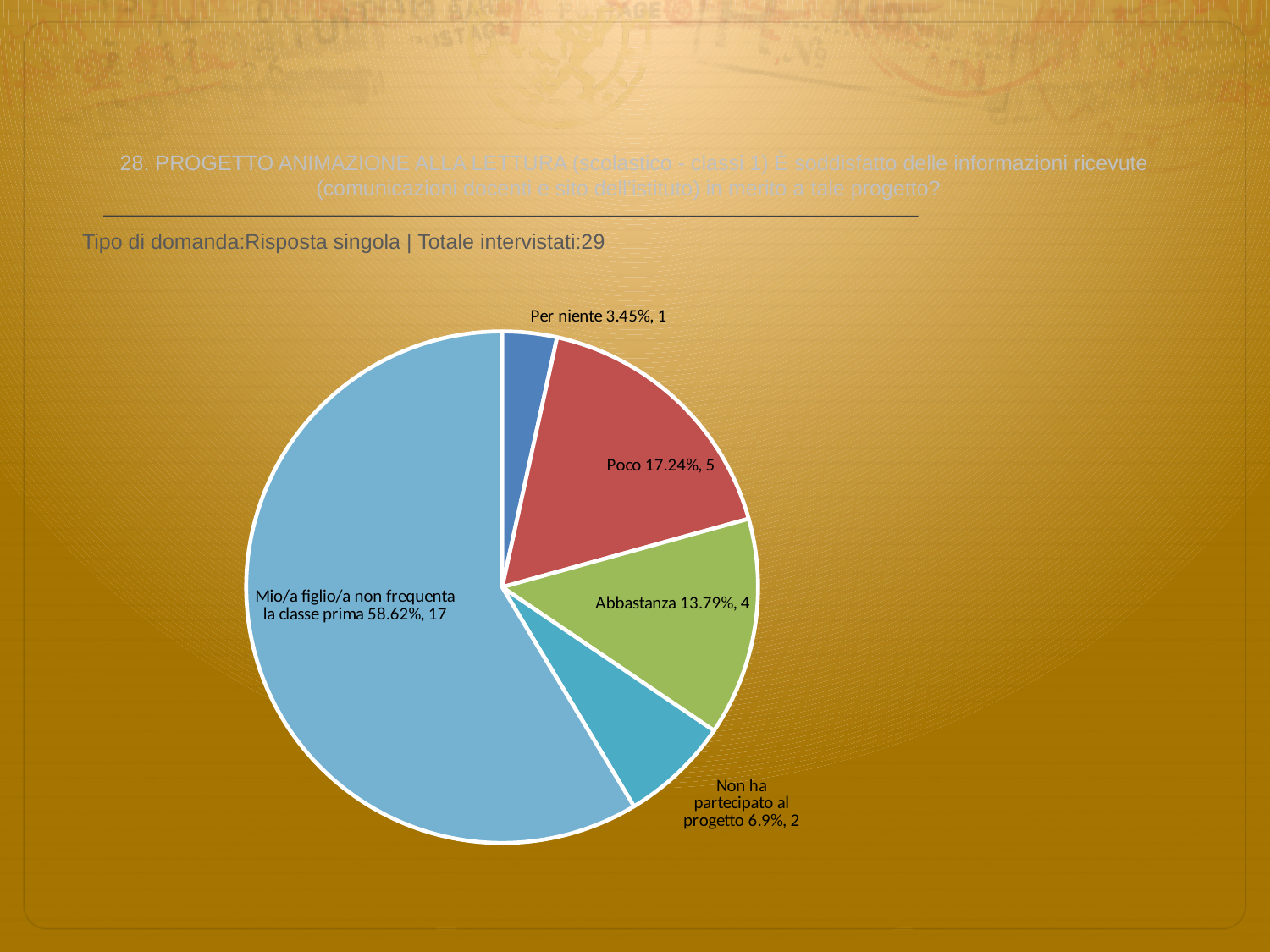
How many respondents answered 'Abbastanza'? 4 Which category has the largest slice of the pie? Mio/a figlio/a non frequenta la classe prima What kind of chart is shown on the slide? pie chart What percentage share does the 'Poco' slice have? 17.24% How many slices does the pie chart have? 5 What percentage share does 'Per niente' have? 3.45% Which category has the smallest slice of the pie? Per niente What is the difference in count between 'Poco' and 'Abbastanza'? 1 What is the total number of respondents stated on the slide? 29 Which has more respondents, 'Poco' or 'Non ha partecipato al progetto'? Poco What is the count for 'Non ha partecipato al progetto'? 2 What percentage share does 'Mio/a figlio/a non frequenta la classe prima' have? 58.62%